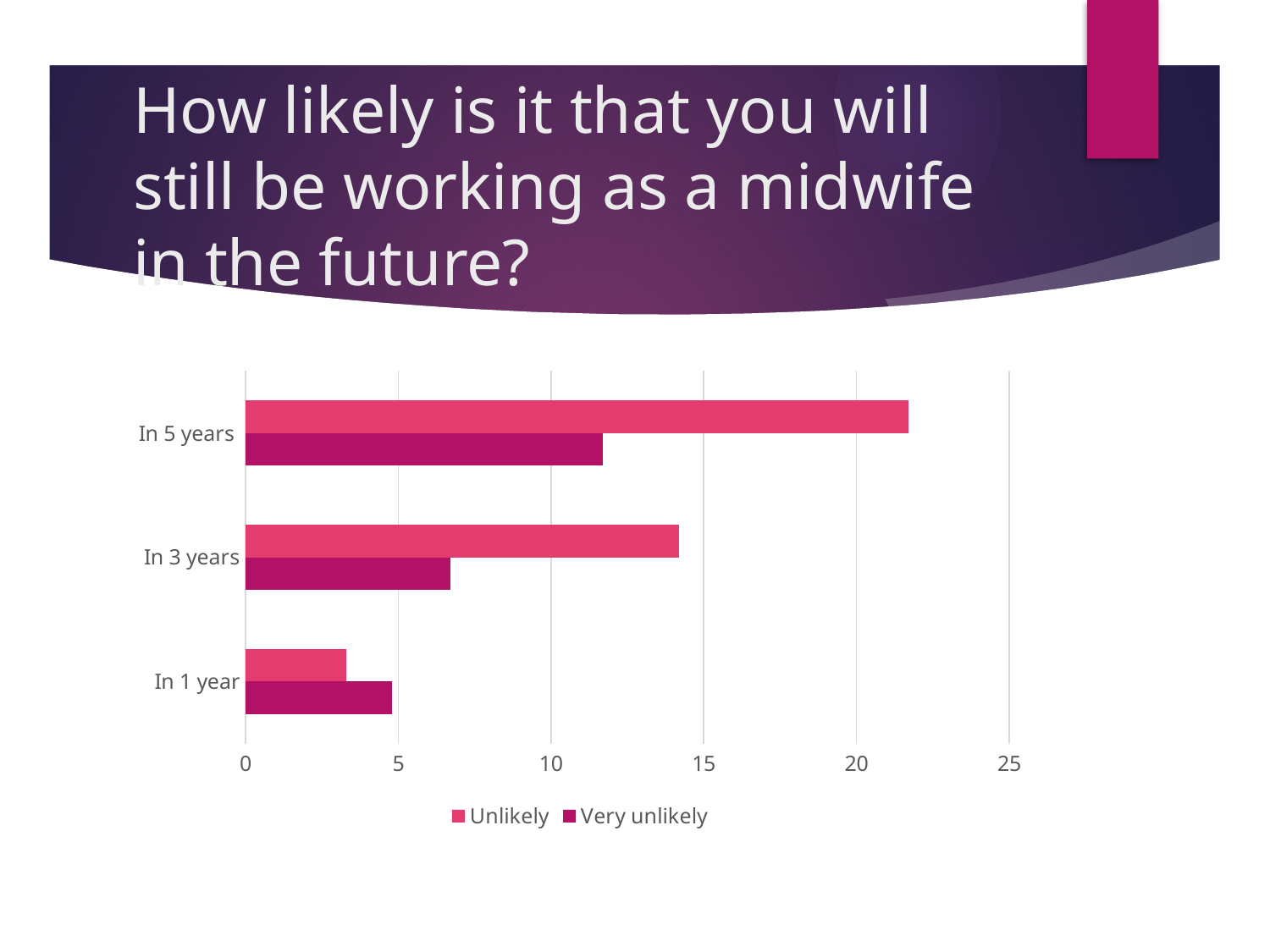
Is the Unlikely value for In 1 year greater or less than 5? less Is the Very unlikely value for In 5 years greater or less than 10? greater What are the two series named in the legend? Unlikely and Very unlikely For In 1 year, which series has the larger value, Unlikely or Very unlikely? Very unlikely How many categories are shown on the chart? 3 Which category has the highest value for the Very unlikely series? In 5 years Is the Unlikely value for In 5 years greater or less than 20? greater How many series does the legend list? 2 What kind of chart is shown on the slide? bar chart Which category has the highest value for the Unlikely series? In 5 years Which category has the lowest value for the Unlikely series? In 1 year